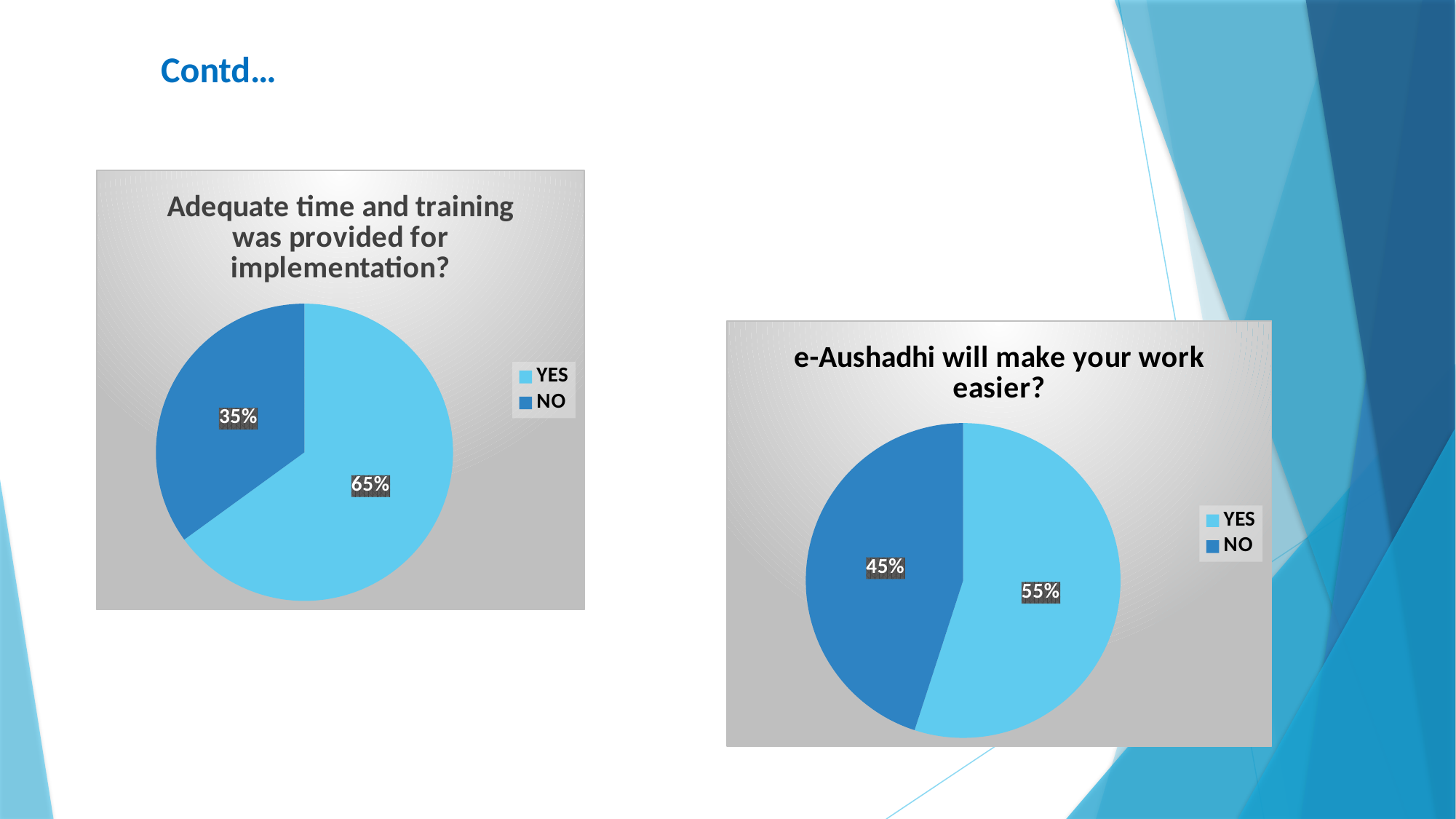
In the chart titled "e-Aushadhi will make your work easier?", what percentage answered YES? 55% In the chart titled "e-Aushadhi will make your work easier?", which response has the smallest share? NO In the chart titled "Adequate time and training was provided for implementation?", what percentage answered YES? 65% In the chart titled "Adequate time and training was provided for implementation?", what percentage answered NO? 35% What type of chart is used on the left of the slide? Pie chart Is the YES share larger in the left chart or the right chart? Left chart In the chart titled "Adequate time and training was provided for implementation?", what is the difference between the YES and NO shares? 30% In the chart titled "e-Aushadhi will make your work easier?", what percentage answered NO? 45% How many entries does the legend of the chart titled "Adequate time and training was provided for implementation?" list? 2 In the chart titled "e-Aushadhi will make your work easier?", what is the difference between the YES and NO shares? 10% In the chart titled "Adequate time and training was provided for implementation?", which response has the largest share? YES How many slices does the chart titled "e-Aushadhi will make your work easier?" have? 2